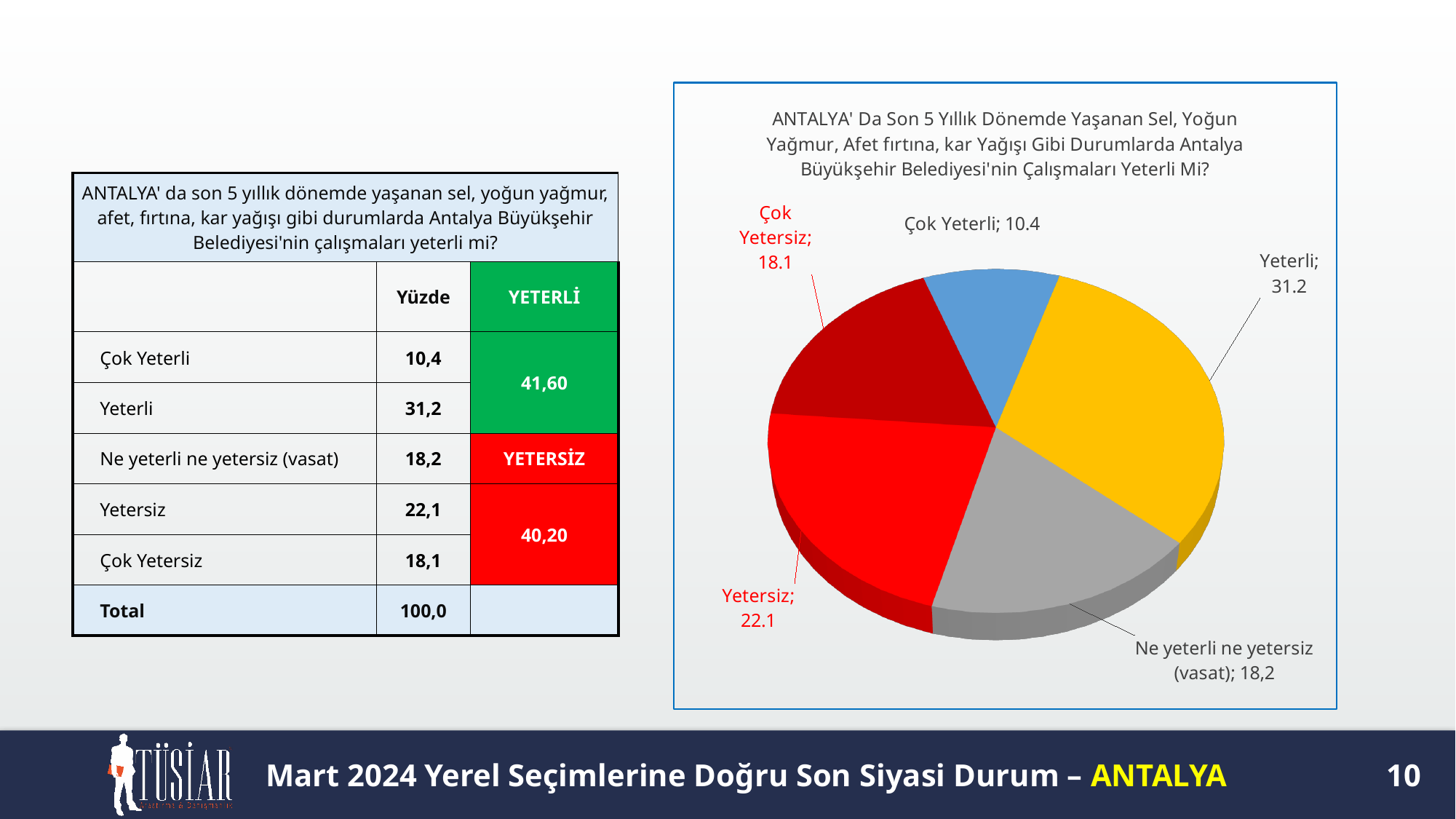
What is the value for Çok Yetersiz in the pie chart? 18.1 What is the value for Çok Yeterli in the pie chart? 10.4 Which slice of the pie chart is the smallest? Çok Yeterli What is the value for Yetersiz in the pie chart? 22.1 Which slice of the pie chart is the largest? Yeterli How many slices does the pie chart have? 5 What colour is the Yeterli slice in the pie chart? Yellow What is the value for Yeterli in the pie chart? 31.2 What is the value for Ne yeterli ne yetersiz (vasat) in the pie chart? 18,2 Which is larger in the pie chart, Yetersiz or Çok Yetersiz? Yetersiz What is the difference between the Yeterli and Yetersiz values in the pie chart? 9.1 What kind of chart is shown on the slide? Pie chart